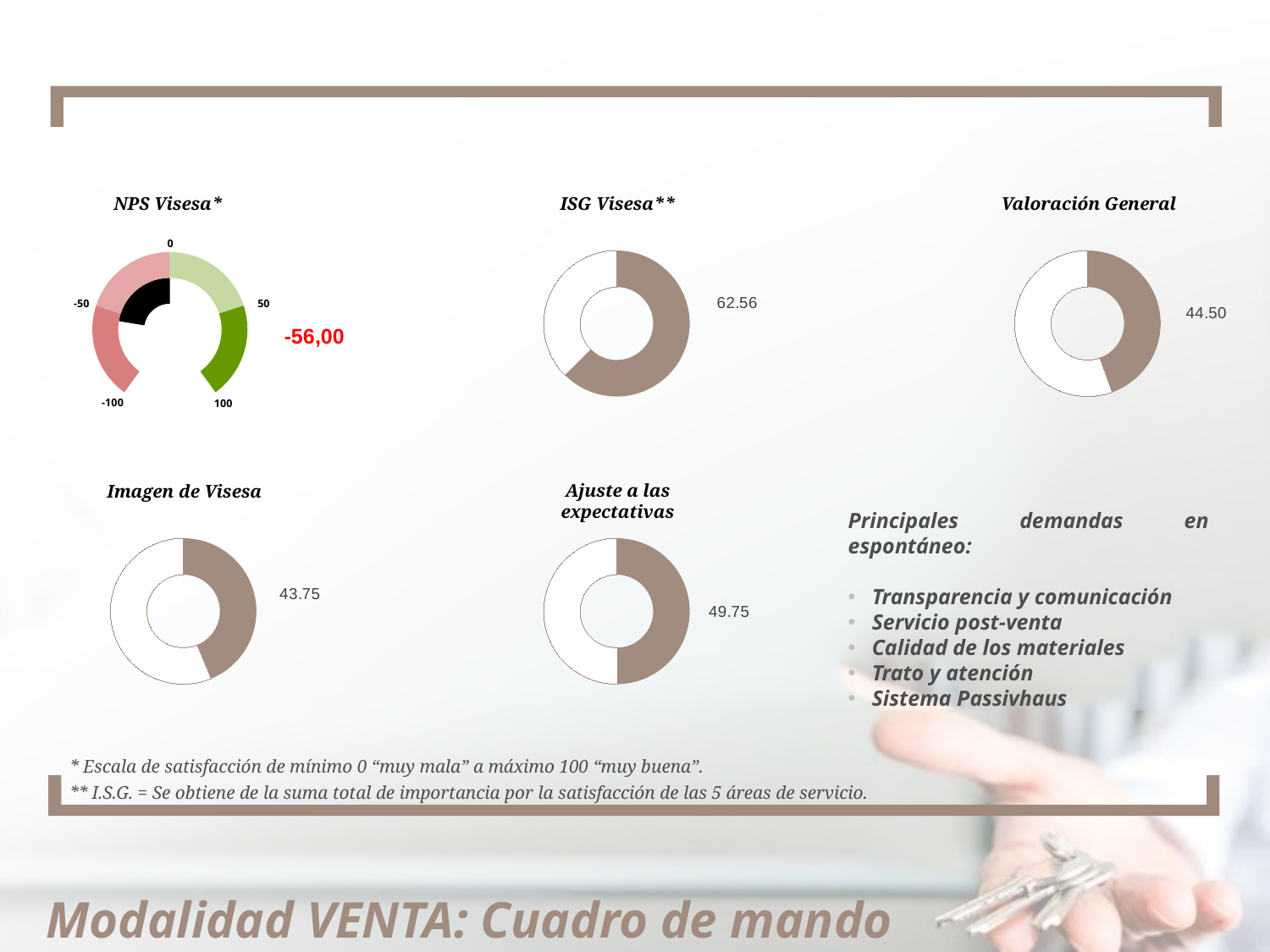
On the 'Ajuste a las expectativas' chart, what value is shown? 49.75 On the 'Valoración General' chart, what value is shown? 44.50 What is the difference between the value on the 'ISG Visesa**' chart and the value on the 'Valoración General' chart? 18.06 Which of the donut charts on the slide shows the highest value? ISG Visesa** Which is larger: the value on the 'Ajuste a las expectativas' chart or the value on the 'Imagen de Visesa' chart? Ajuste a las expectativas On the 'ISG Visesa**' chart, what value is shown? 62.56 What kind of chart is the 'NPS Visesa*' chart? Gauge chart Which of the donut charts on the slide shows the lowest value? Imagen de Visesa What kind of chart is the 'ISG Visesa**' chart? Donut chart On the 'Imagen de Visesa' chart, what value is shown? 43.75 On the 'NPS Visesa*' gauge chart, what value is displayed? -56,00 On the 'NPS Visesa*' gauge chart, what are the minimum and maximum values marked on the scale? -100 and 100